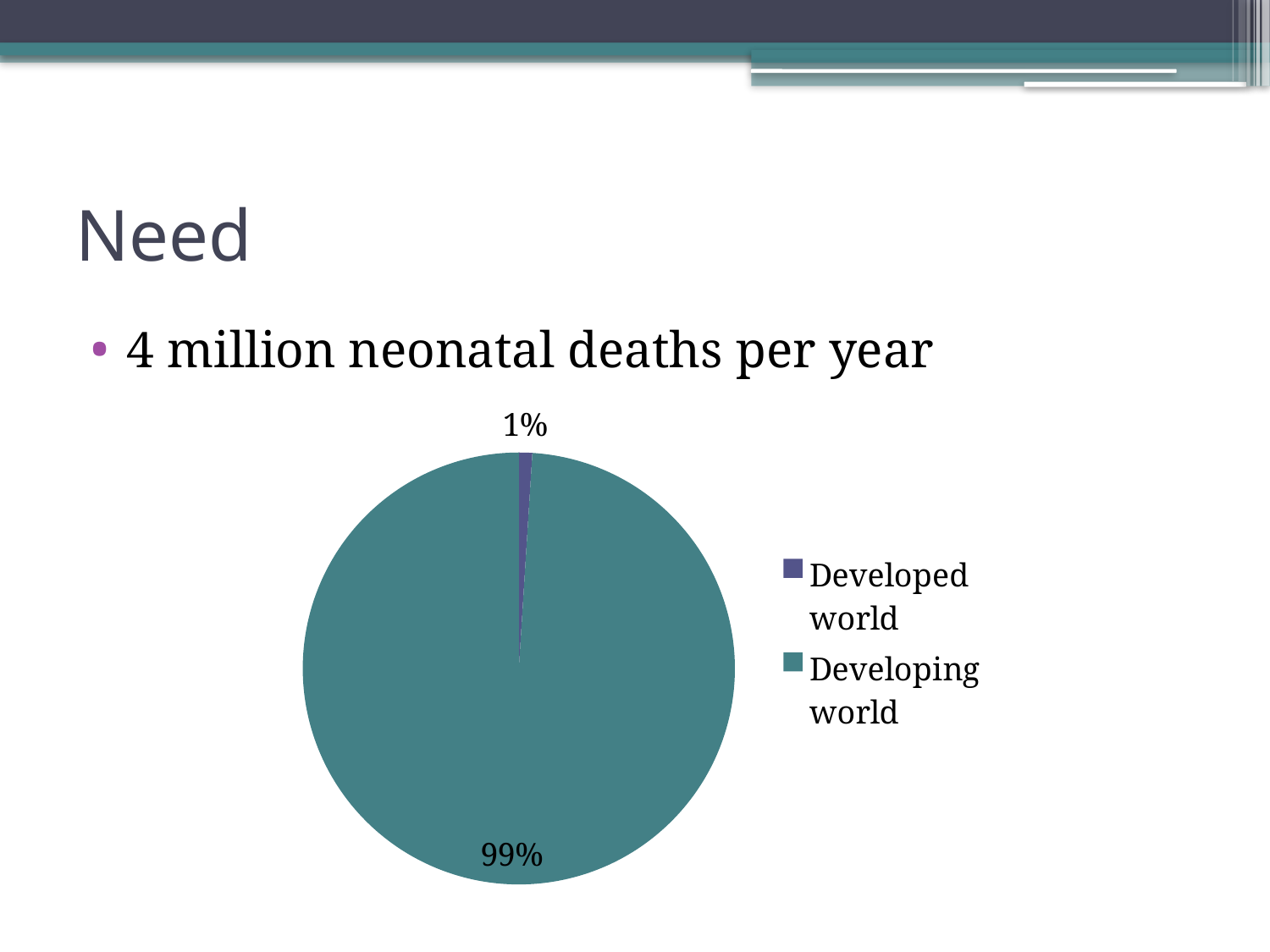
What kind of chart is shown on the slide? pie chart Which category has the smallest slice of the pie? Developed world Which category has the largest slice of the pie? Developing world What colour is the Developing world slice? teal How many entries does the legend list? 2 What share of the pie does the Developed world slice represent? 1% What colour is the Developed world slice? purple What share of the pie does the Developing world slice represent? 99% How many categories does the pie chart show? 2 Which is larger, the Developed world slice or the Developing world slice? Developing world What is the difference in percentage points between the Developing world and Developed world slices? 98